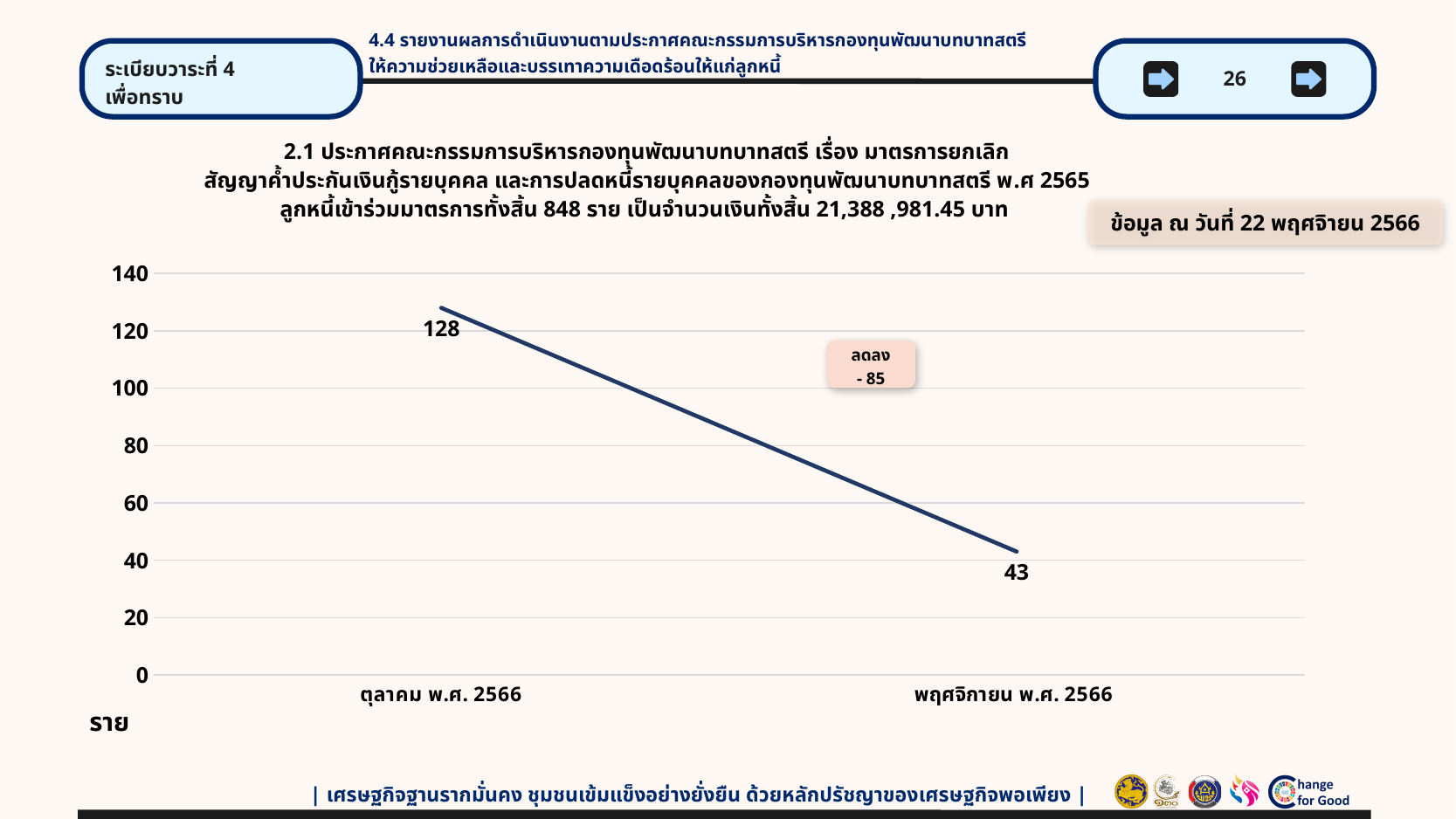
Which month has the lowest value? พฤศจิกายน พ.ศ. 2566 How many data points are plotted on the chart? 2 What change is stated in the annotation box on the chart? ลดลง - 85 Which month has the highest value? ตุลาคม พ.ศ. 2566 What is the difference between the values for ตุลาคม พ.ศ. 2566 and พฤศจิกายน พ.ศ. 2566? 85 Is the value for พฤศจิกายน พ.ศ. 2566 greater or less than 60? less Which is larger, the value for ตุลาคม พ.ศ. 2566 or the value for พฤศจิกายน พ.ศ. 2566? ตุลาคม พ.ศ. 2566 What is the value for ตุลาคม พ.ศ. 2566? 128 What kind of chart is shown on the slide? line chart Do the values rise or fall from ตุลาคม พ.ศ. 2566 to พฤศจิกายน พ.ศ. 2566? fall What is the value for พฤศจิกายน พ.ศ. 2566? 43 Is the value for ตุลาคม พ.ศ. 2566 greater or less than 100? greater